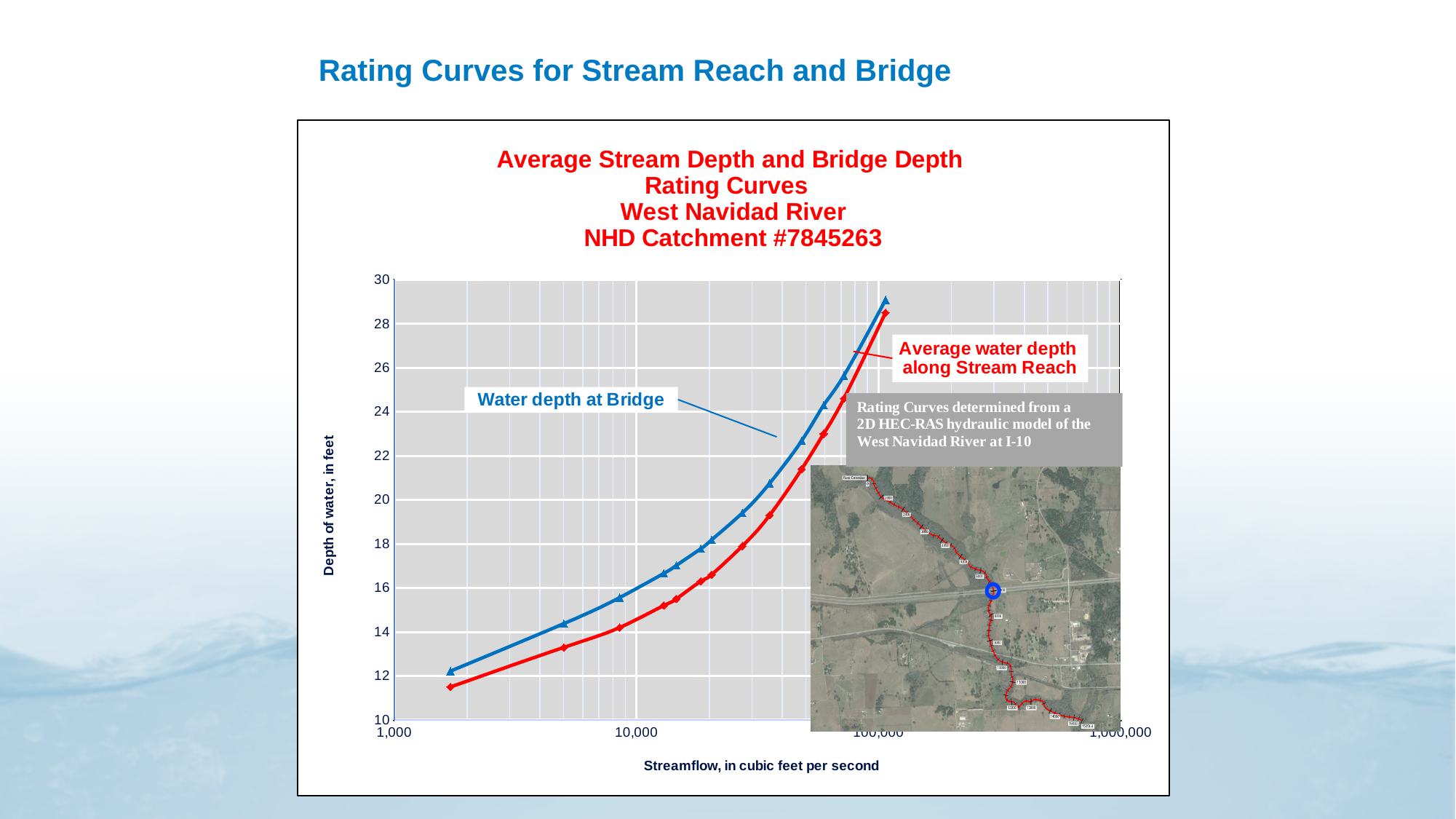
What is the title of the chart? Average Stream Depth and Bridge Depth Rating Curves West Navidad River NHD Catchment #7845263 Which series reaches the highest depth on the chart? Water depth at Bridge Is the lowest value for Water depth at Bridge greater or less than 14? less How many series are plotted on the chart? 2 Which series has the lowest depth value on the chart? Average water depth along Stream Reach Do the depth values rise or fall as streamflow increases along the x axis? rise Is the highest value for Water depth at Bridge greater or less than 28? greater What kind of chart is shown on the slide? line chart What is the label of the y axis? Depth of water, in feet Is the lowest value for Average water depth along Stream Reach greater or less than 12? less Which series shows the higher water depth at a given streamflow, Water depth at Bridge or Average water depth along Stream Reach? Water depth at Bridge